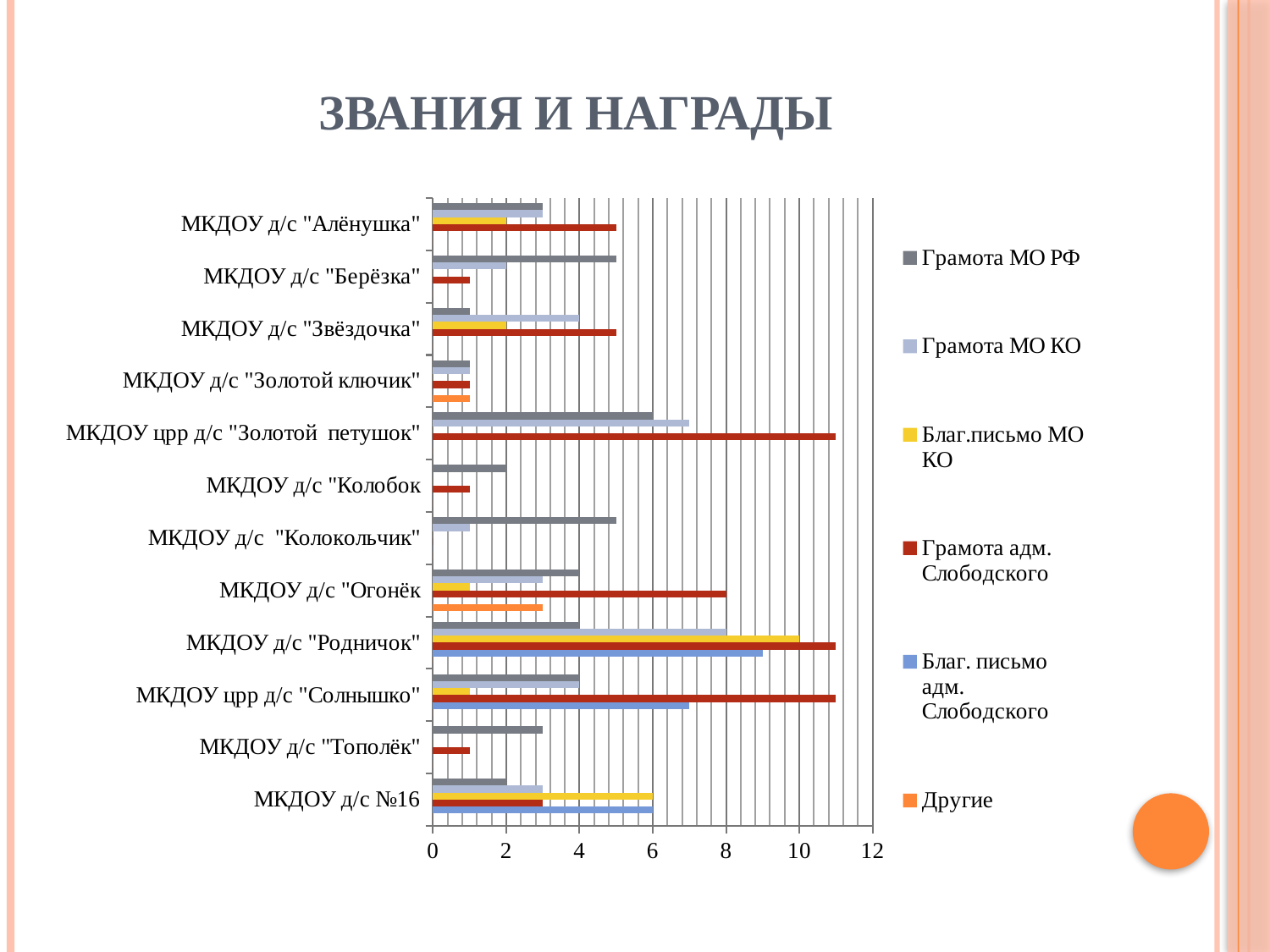
How many series does the legend list? 6 What is the value of Грамота МО РФ for МКДОУ црр д/с "Золотой петушок"? 6 Is the value of Грамота МО РФ for МКДОУ д/с "Алёнушка" greater or less than 4? less Which category has the highest value for Благ.письмо МО КО? МКДОУ д/с "Родничок" What is the value of Благ.письмо МО КО for МКДОУ д/с "Родничок"? 10 What is the title of the slide? ЗВАНИЯ И НАГРАДЫ Which is larger for МКДОУ д/с "Звёздочка": Грамота МО КО or Грамота МО РФ? Грамота МО КО How many categories (kindergartens) are shown on the chart? 12 Which is larger for МКДОУ црр д/с "Солнышко": Грамота адм. Слободского or Благ. письмо адм. Слободского? Грамота адм. Слободского What is the value of Грамота адм. Слободского for МКДОУ д/с "Огонёк"? 8 Is the value of Грамота адм. Слободского for МКДОУ д/с "Родничок" greater or less than 10? greater What kind of chart is shown on the slide? bar chart